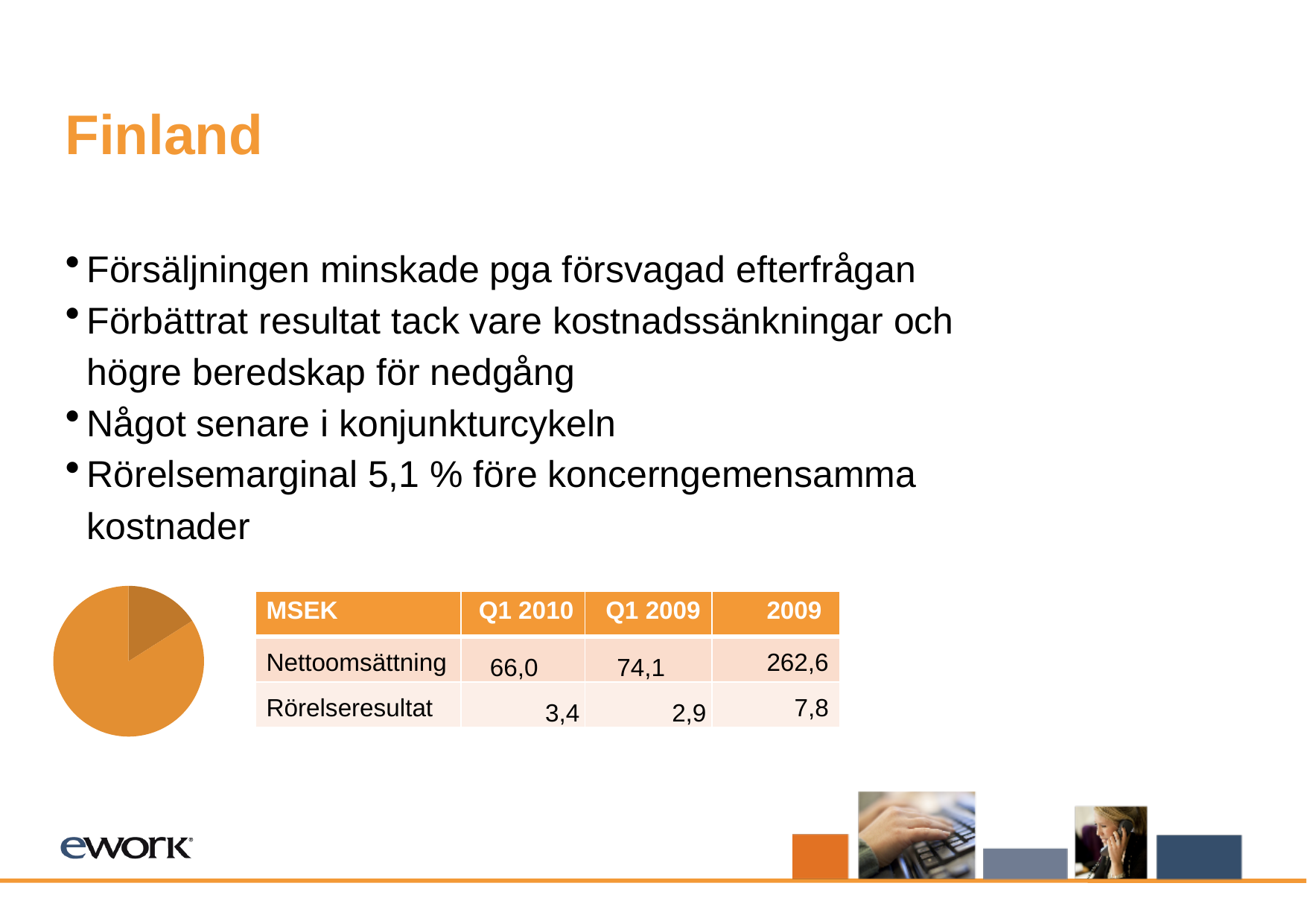
What kind of chart is shown at the bottom left of the slide? pie chart Is the darker brown slice of the pie chart greater or less than half of the pie? less In the pie chart, which slice is larger, the lighter orange slice or the darker brown slice? the lighter orange slice Does the pie chart display a legend? No How many slices does the pie chart have? 2